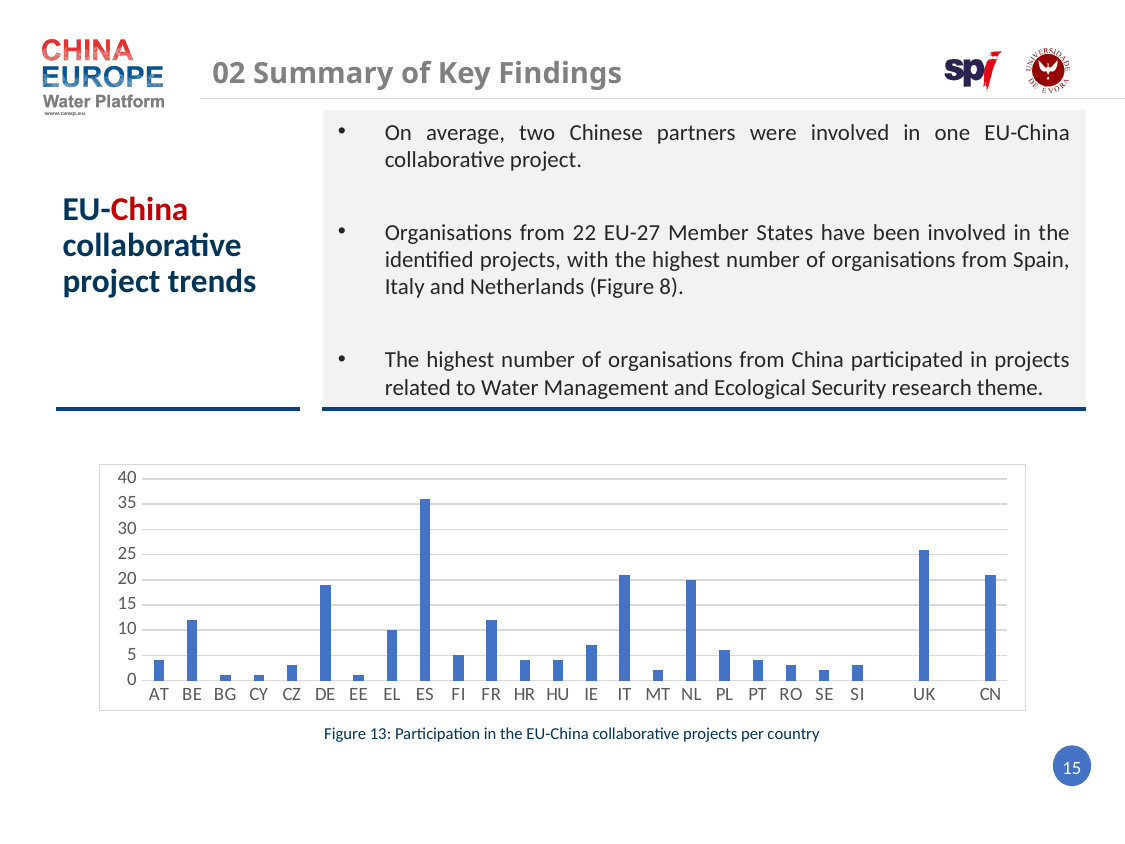
Is the value for ES greater or less than 30? greater Which has a larger value, DE or BE? DE Is the value for BE greater or less than 10? greater How many countries are shown on the x axis of the chart? 24 Which has a larger value, UK or CN? UK Is the value for MT greater or less than 5? less What is the caption of the figure below the chart? Figure 13: Participation in the EU-China collaborative projects per country Which country has the highest bar in the chart? ES What kind of chart is shown on the slide? bar chart